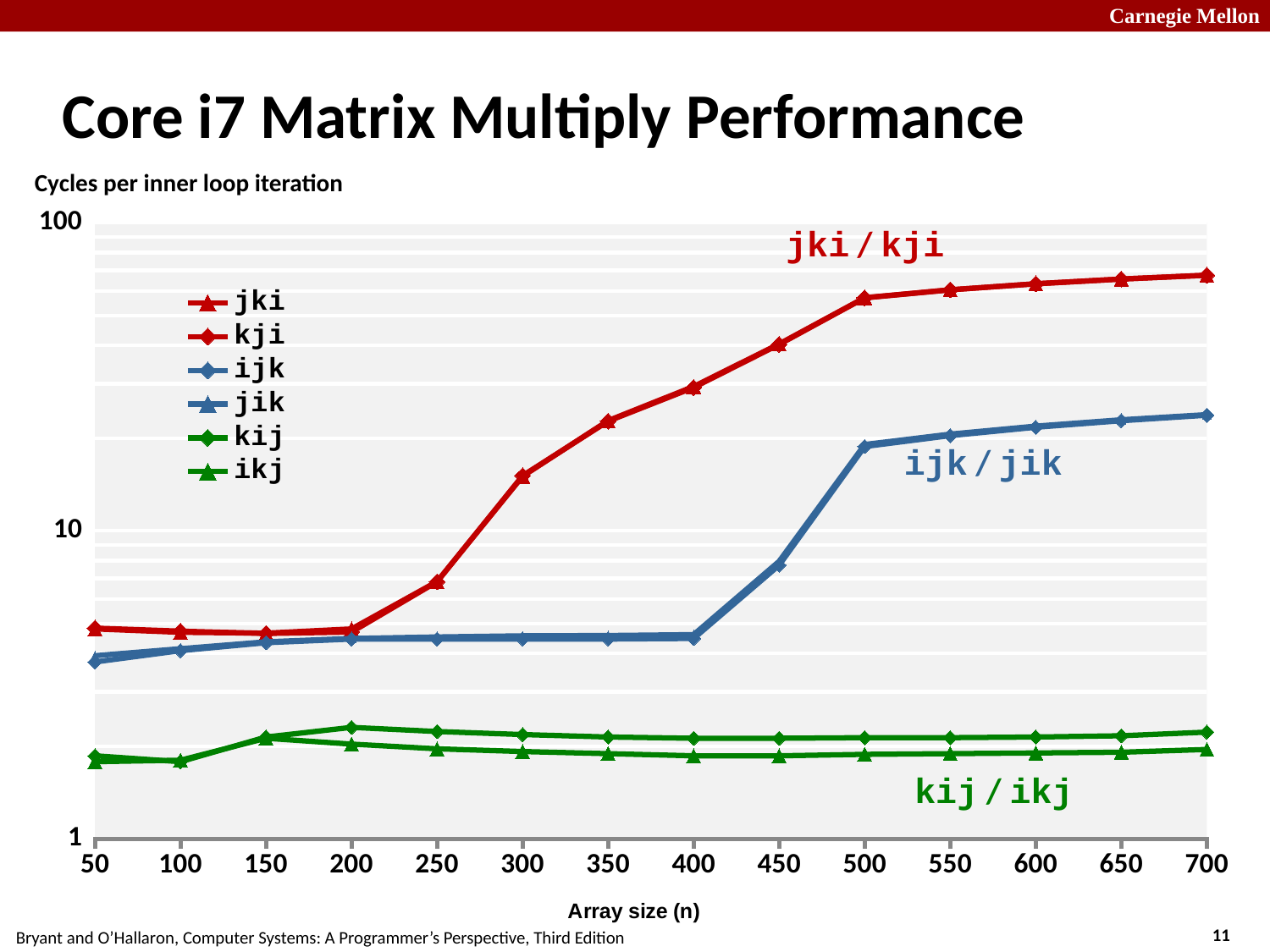
Is the value for ijk at array size 400 greater or less than 10? less At array size 50, which is larger, the value for kji or the value for ikj? kji How many series does the legend list? 6 How many array size values are marked along the x axis? 14 Is the value for kij at array size 700 greater or less than 10? less At array size 300, which is larger, the value for jki or the value for ijk? jki What is the label on the x axis of the chart? Array size (n) Do the values for jki rise or fall as the array size increases from 200 to 700? rise Is the value for jki at array size 100 greater or less than 10? less What kind of chart is shown on the slide? line chart